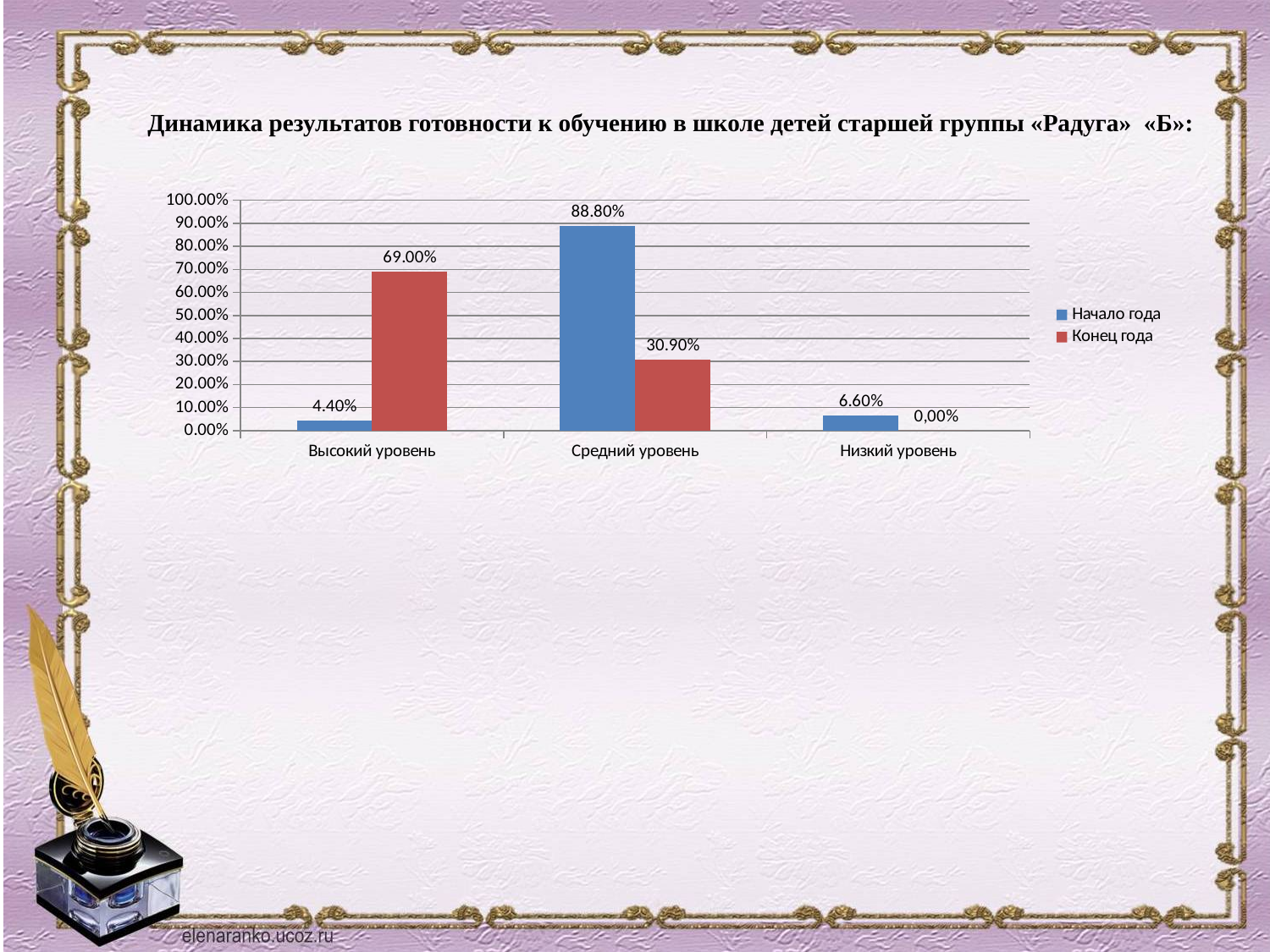
How many series does the legend list? 2 Which category has the lowest value in the Конец года series? Низкий уровень What is the value for Средний уровень in the Начало года series? 88.80% What is the difference between the Начало года and Конец года values for Средний уровень? 57.90% Which category has the highest value in the Начало года series? Средний уровень For Высокий уровень, which series has the larger value: Начало года or Конец года? Конец года What is the value for Высокий уровень in the Начало года series? 4.40% What is the value for Низкий уровень in the Конец года series? 0,00% Which colour represents the Конец года series? Red What is the value for Высокий уровень in the Конец года series? 69.00% How many categories are shown on the x axis? 3 What kind of chart is shown on the slide? Bar chart